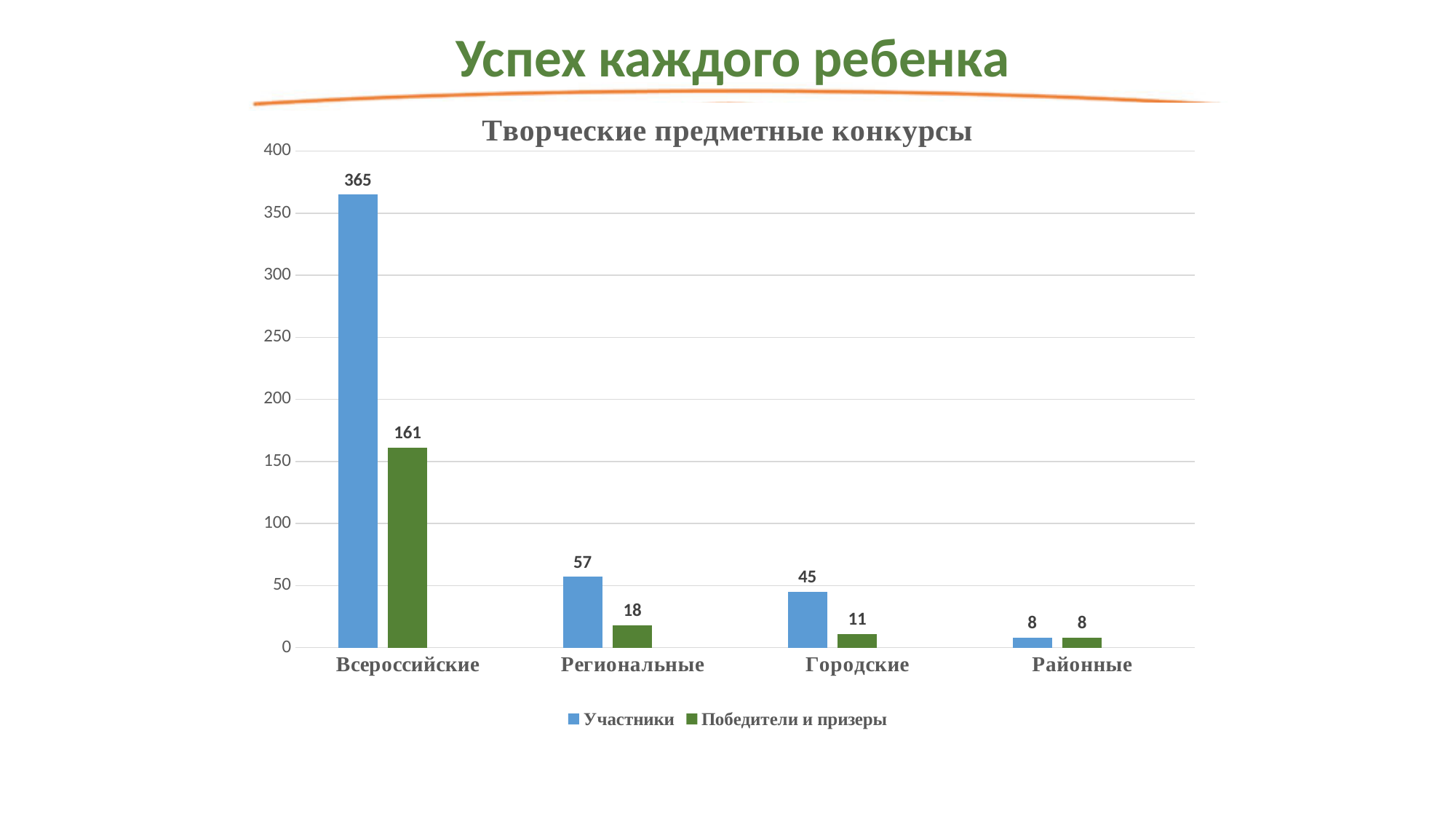
How many categories are shown on the x axis? 4 Which category has the highest value for Участники? Всероссийские Do the values for Участники rise or fall from Всероссийские to Районные? Fall Which is larger in the Региональные category: Участники or Победители и призеры? Участники What is the value for Победители и призеры in the Региональные category? 18 What is the title of the chart? Творческие предметные конкурсы What is the value for Участники in the Городские category? 45 What is the difference between Участники and Победители и призеры in the Всероссийские category? 204 How many series does the legend list? 2 Which category has the lowest value for Победители и призеры? Районные What kind of chart is shown on the slide? Bar chart What is the value for Участники in the Всероссийские category? 365